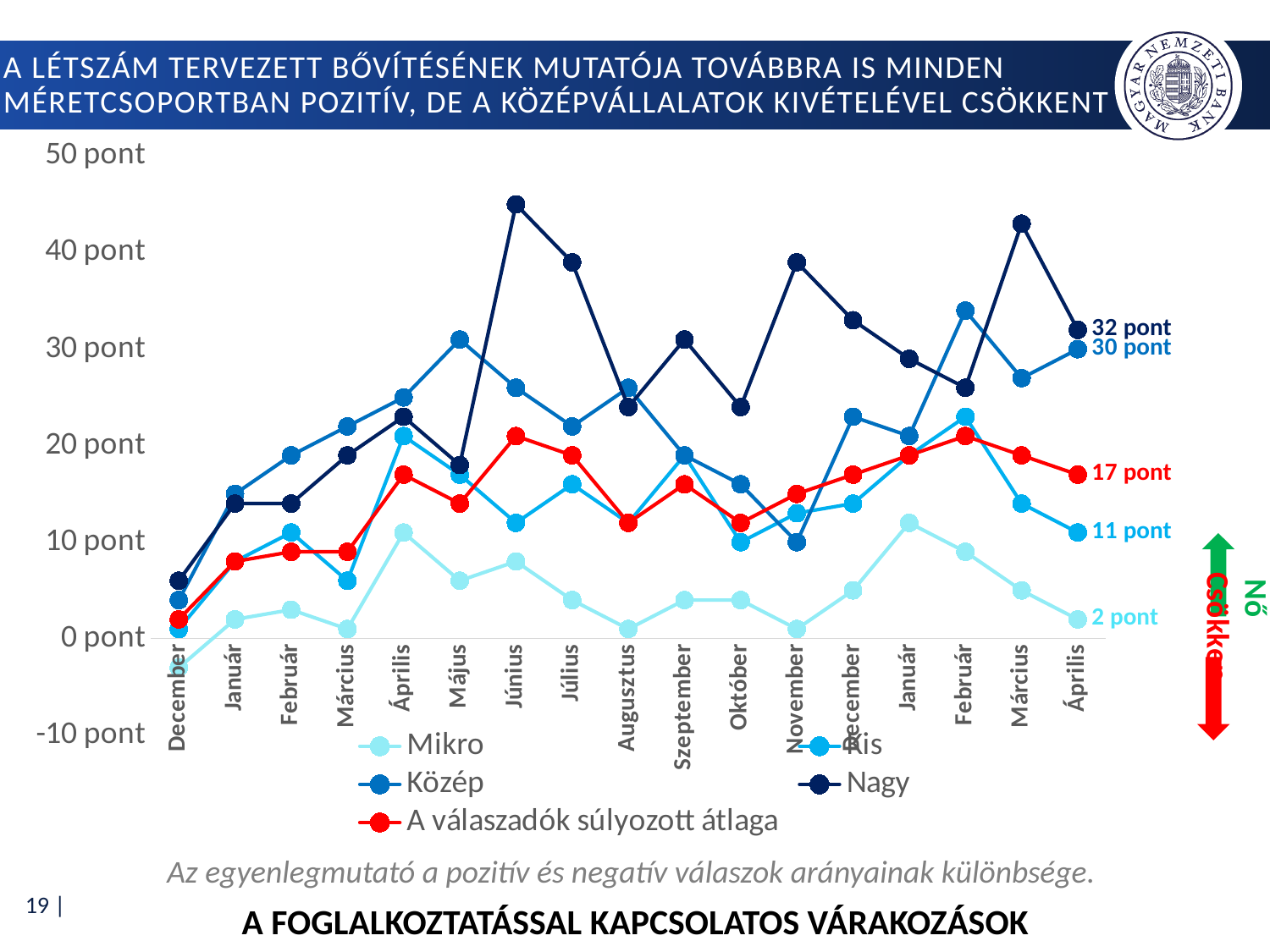
Does the Mikro series rise or fall from the second Február to the final Április? fall Which series has the highest value at the final Április point? Nagy How many months are shown along the x axis? 17 What is the value for Közép at the final Április point? 30 pont What type of chart is shown on the slide? line chart What is the value for A válaszadók súlyozott átlaga at the final Április point? 17 pont What is the difference between the Nagy and Közép values at the final Április point? 2 pont How many series does the legend list? 5 Is the value for Nagy in Június greater or less than 40 pont? greater What is the value for Mikro at the final Április point? 2 pont What is the value for Nagy at the final Április point? 32 pont Which series has the lowest value at the final Április point? Mikro